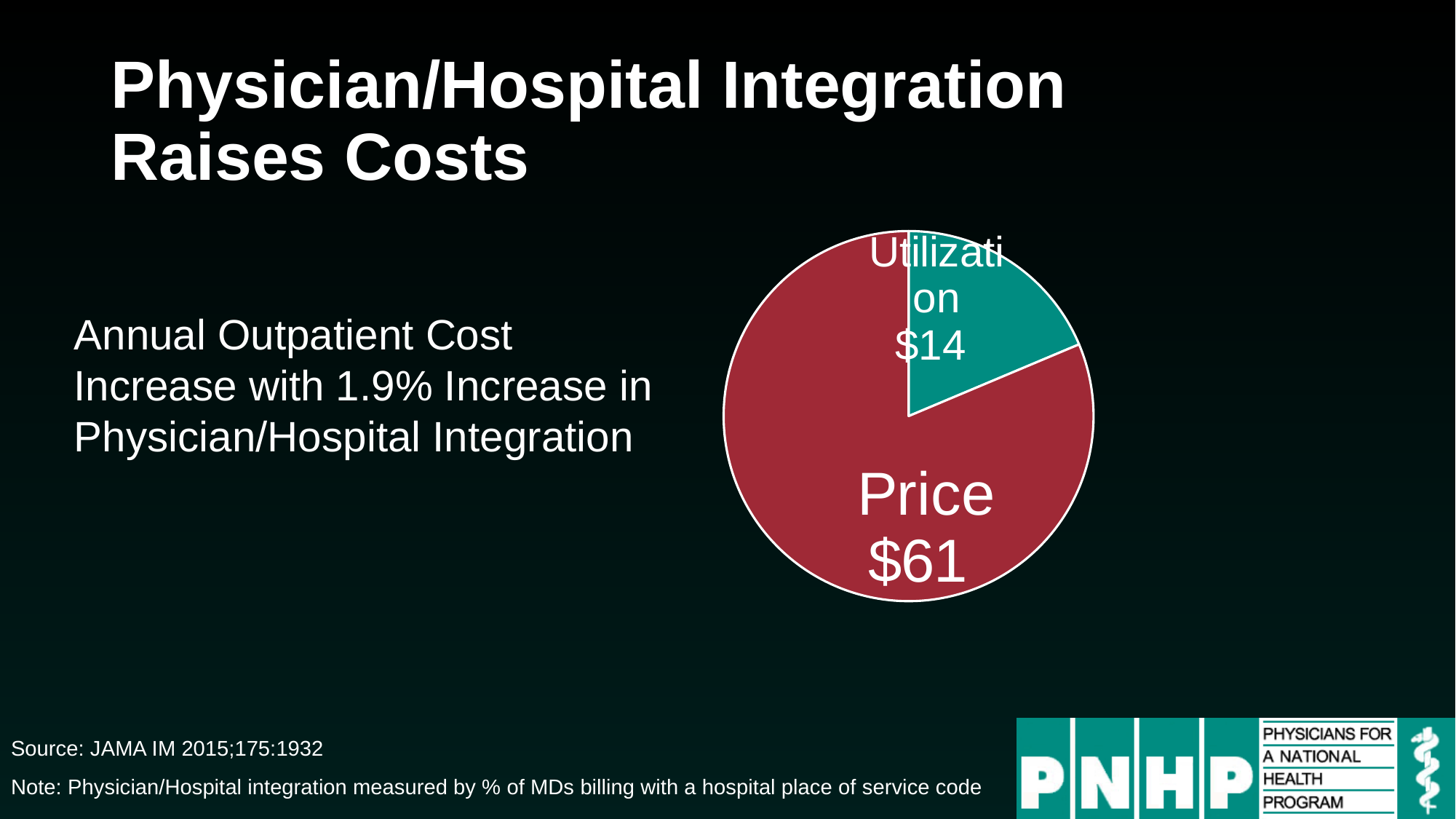
What colour is the Price slice in the pie chart? red Which slice of the pie chart is the largest? Price What colour is the Utilization slice in the pie chart? teal How many slices does the pie chart have? 2 What is the value of the Price slice in the pie chart? $61 What is the difference between the Price and Utilization values in the pie chart? $47 Which slice of the pie chart is the smallest? Utilization What is the total of the two slices in the pie chart? $75 What kind of chart is shown on the slide? pie chart Which is larger in the pie chart, Price or Utilization? Price What is the value of the Utilization slice in the pie chart? $14